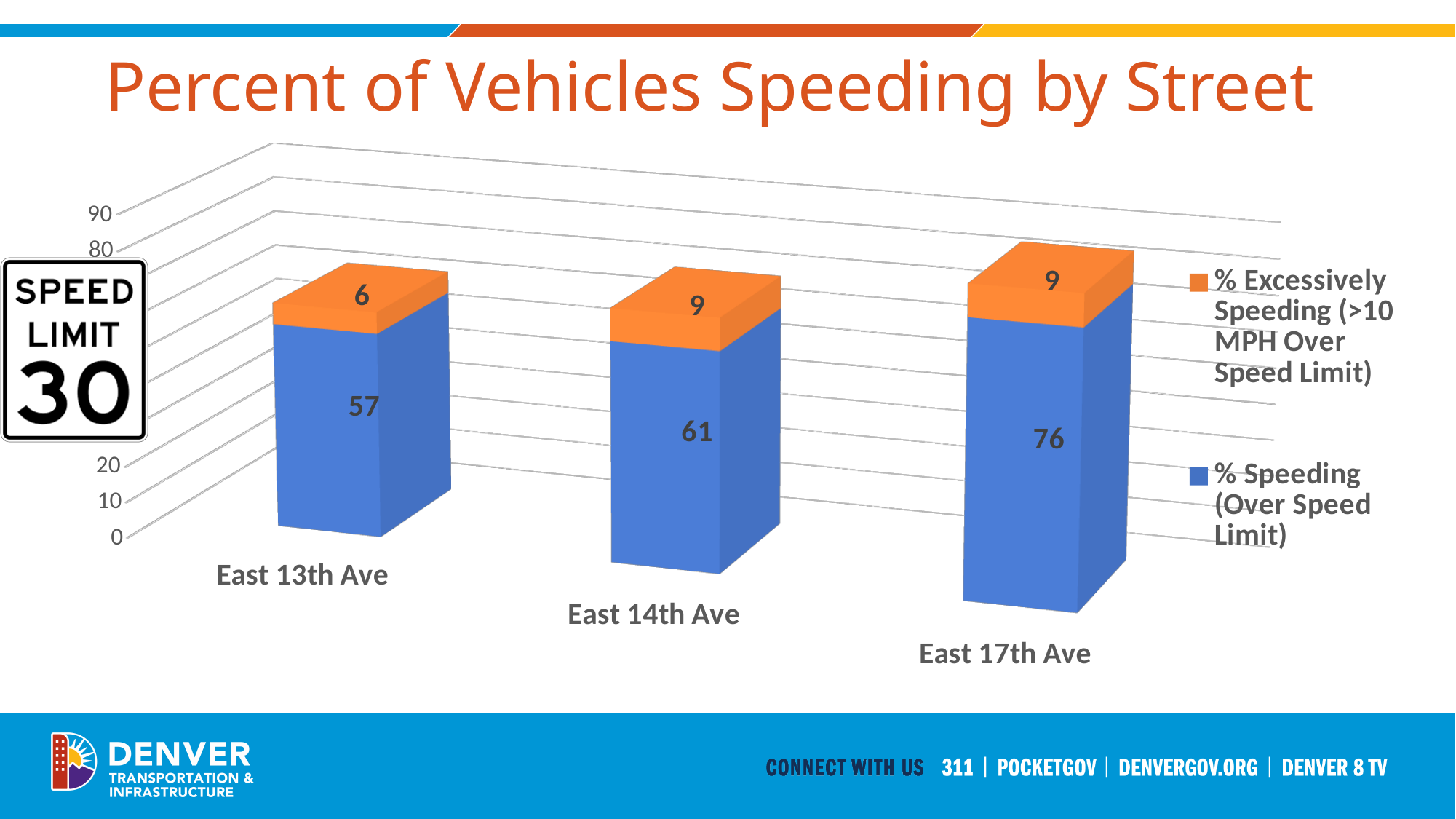
What is the total of the stacked bar for East 17th Ave? 85 What is the % Speeding (Over Speed Limit) value for East 17th Ave? 76 Which is larger: the % Speeding (Over Speed Limit) value for East 14th Ave or for East 13th Ave? East 14th Ave Which street has the highest % Speeding (Over Speed Limit) value? East 17th Ave What is the % Excessively Speeding (>10 MPH Over Speed Limit) value for East 14th Ave? 9 What is the % Speeding (Over Speed Limit) value for East 13th Ave? 57 How many streets are shown on the chart? 3 What kind of chart is shown on the slide? Stacked bar chart What is the total of the stacked bar for East 14th Ave? 70 How many series does the legend list? 2 Which street has the lowest % Excessively Speeding (>10 MPH Over Speed Limit) value? East 13th Ave What is the difference between the % Speeding (Over Speed Limit) values for East 17th Ave and East 13th Ave? 19